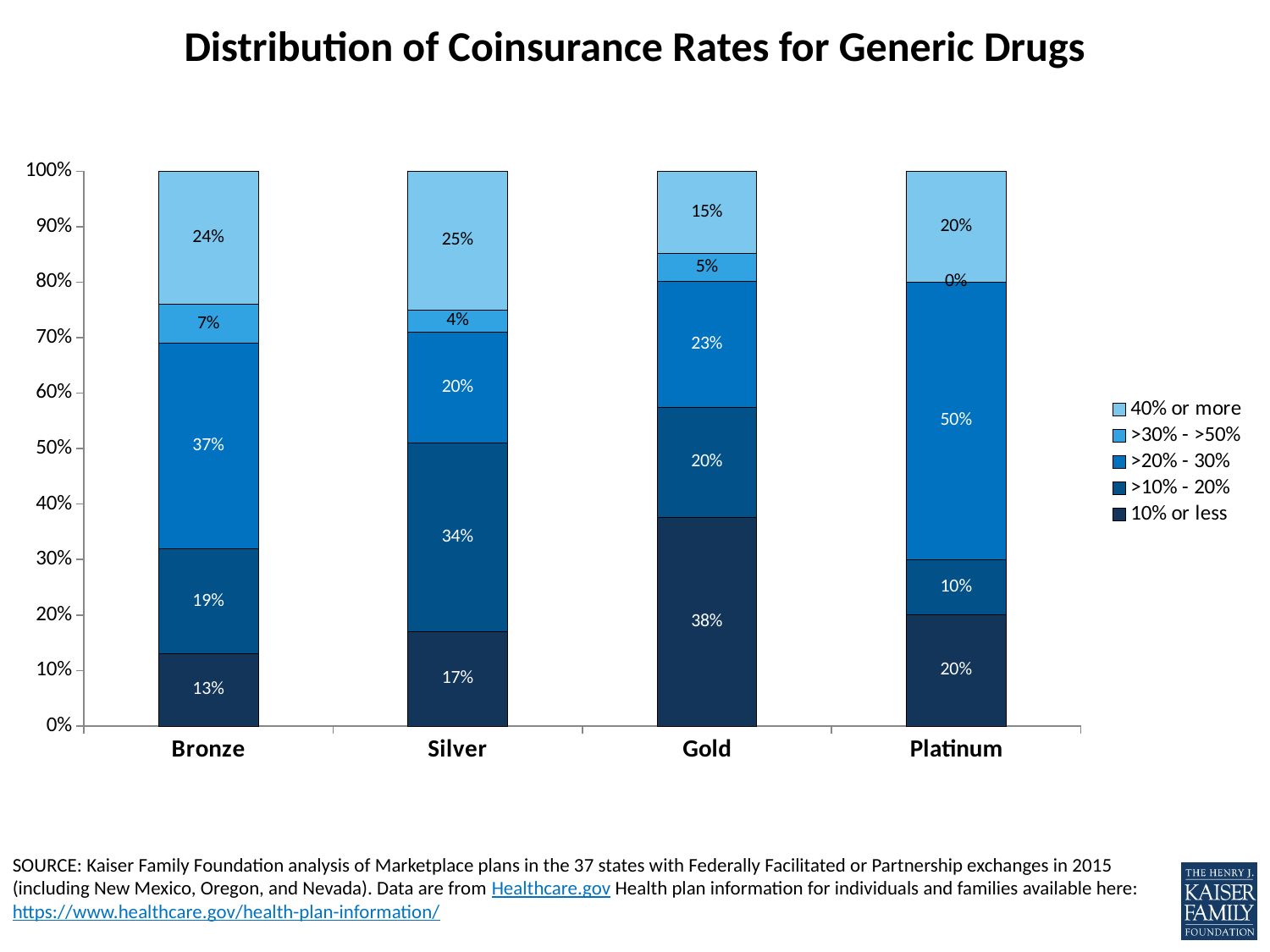
What share of Gold plans have a generic drug coinsurance rate of 10% or less? 38% Which metal tier has the largest share of plans with a coinsurance rate of 10% or less? Gold What share of Platinum plans have a generic drug coinsurance rate of >20% - 30%? 50% What type of chart is shown on the slide? Stacked bar chart What share of Silver plans have a generic drug coinsurance rate of 40% or more? 25% How many series does the legend list? 5 What is the difference between the >20% - 30% share for Platinum and for Bronze? 13% How many metal tiers (categories) are shown on the x axis? 4 Which is larger: the 40% or more share for Bronze or for Gold? Bronze What share of Bronze plans have a generic drug coinsurance rate of >10% - 20%? 19% What is the title of the chart? Distribution of Coinsurance Rates for Generic Drugs Which metal tier has the smallest share of plans with a coinsurance rate of >30% - >50%? Platinum